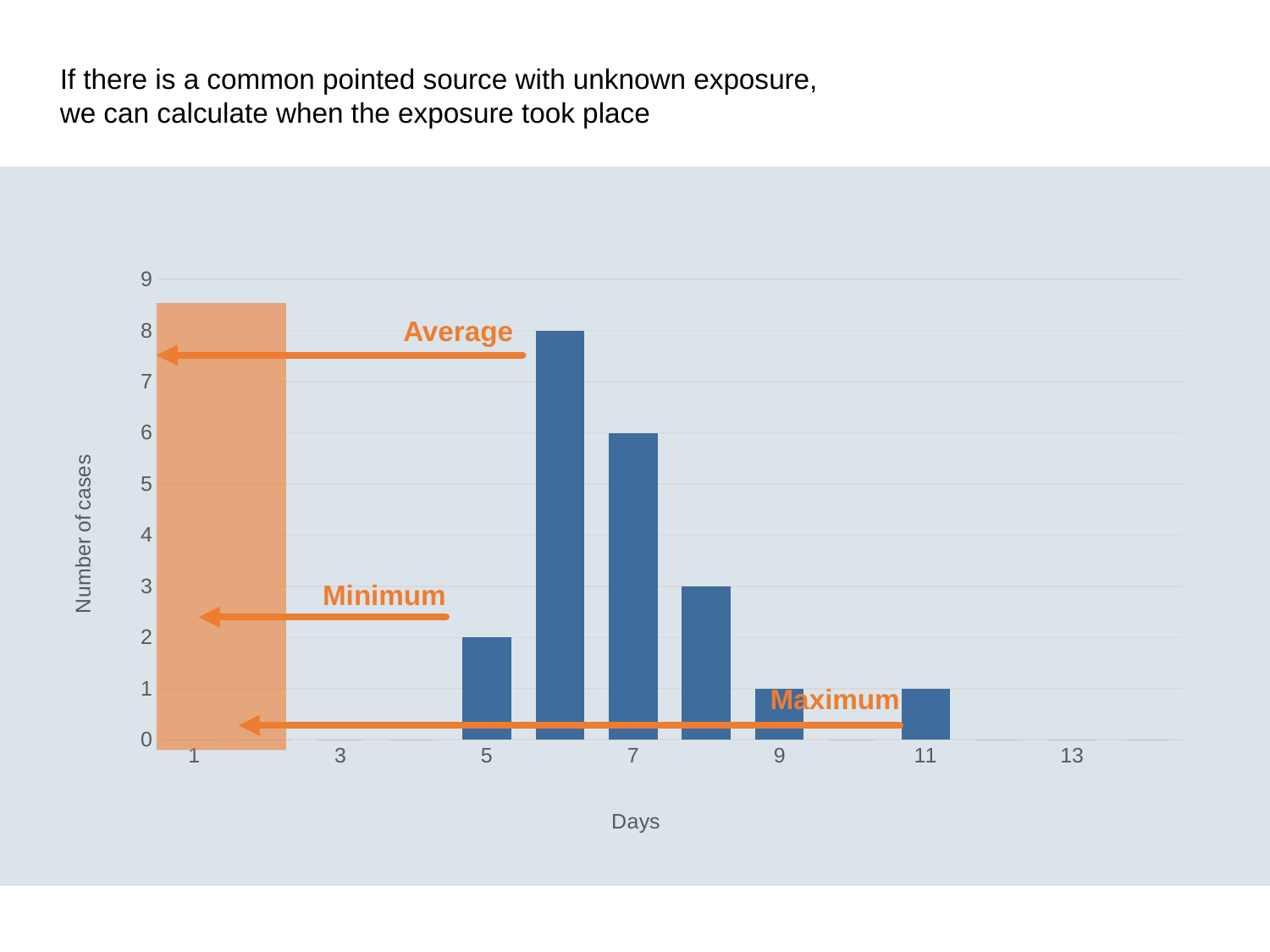
What is the number of cases on day 5? 2 What is the label of the vertical axis? Number of cases What is the number of cases on day 11? 1 Which has more cases, day 5 or day 7? Day 7 What is the difference in number of cases between day 7 and day 5? 4 Is the number of cases on day 7 greater or less than 5? greater How many days have at least one case plotted as a bar? 6 Which day has the highest number of cases? Day 6 What is the number of cases on day 9? 1 What three labels are written on the orange arrows in the chart? Average, Minimum, Maximum What is the number of cases on day 7? 6 What kind of chart is shown on the slide? Bar chart